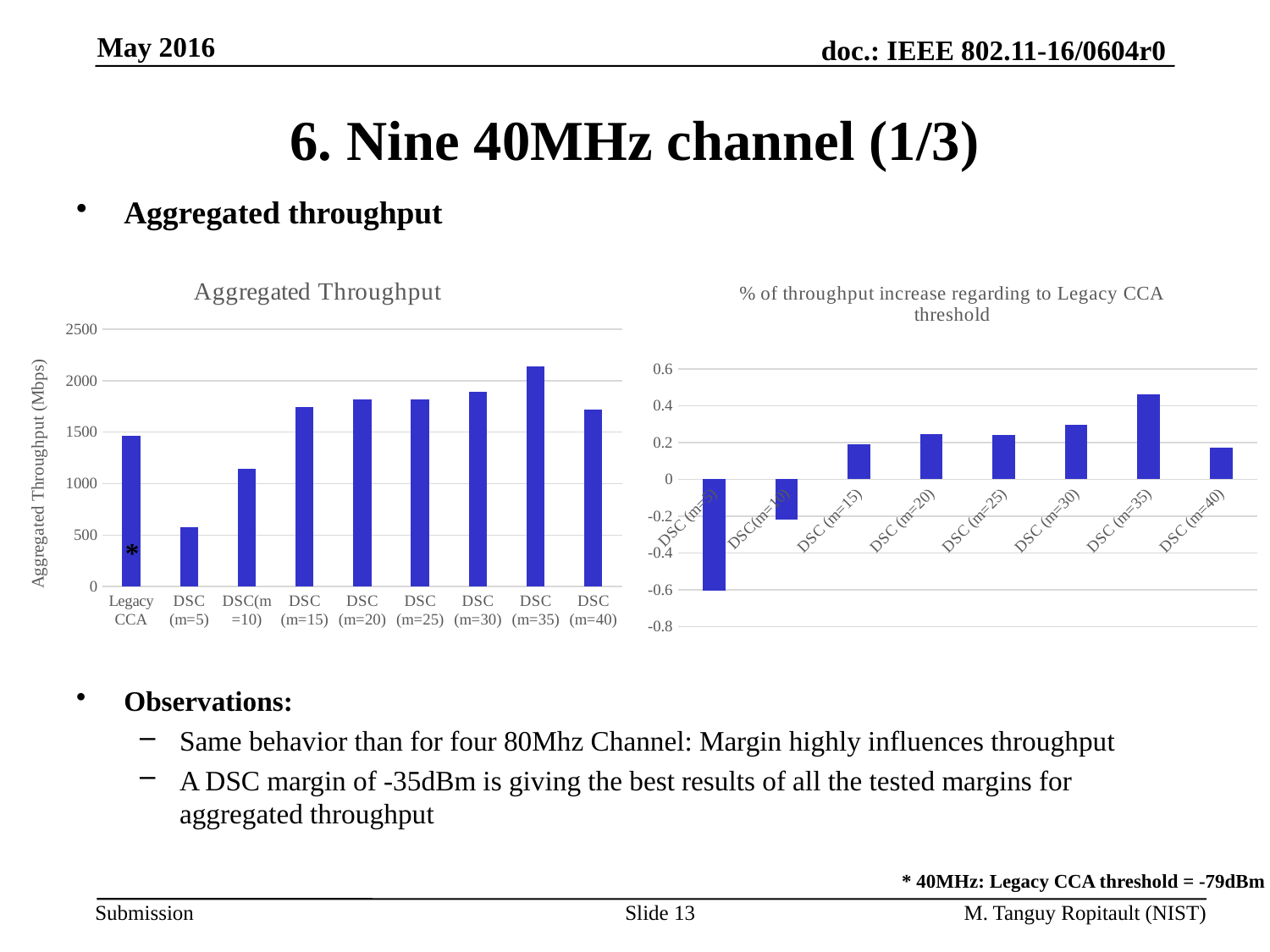
What kind of chart is the Aggregated Throughput chart? bar chart In the Aggregated Throughput chart, is the value for DSC (m=5) greater or less than 1000? less In the Aggregated Throughput chart, is the value for Legacy CCA greater or less than 1000? greater In the Aggregated Throughput chart, which category has the lowest value? DSC (m=5) How many categories are shown in the Aggregated Throughput chart? 9 In the chart titled '% of throughput increase regarding to Legacy CCA threshold', which category has the highest value? DSC (m=35) In the Aggregated Throughput chart, is the value for DSC (m=35) greater or less than 2000? greater What is the y-axis title of the Aggregated Throughput chart? Aggregated Throughput (Mbps) In the Aggregated Throughput chart, which is larger, the value for DSC (m=30) or DSC (m=40)? DSC (m=30) In the chart titled '% of throughput increase regarding to Legacy CCA threshold', which category has the lowest value? DSC (m=5) In the Aggregated Throughput chart, which category has the highest value? DSC (m=35)